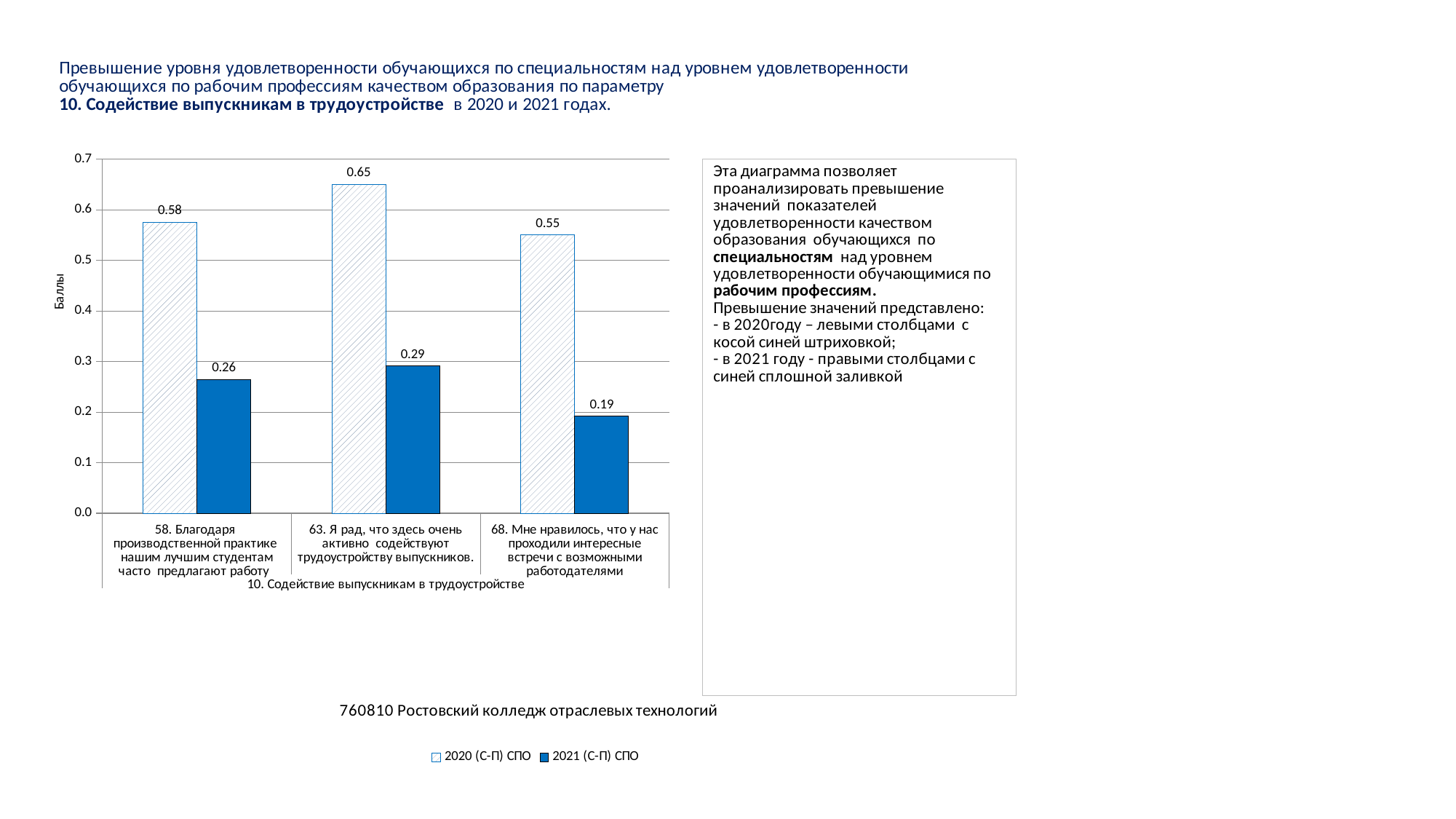
Is the 2020 (С-П) СПО value for item 63 greater or less than 0.6? greater What is the 2020 (С-П) СПО value for item 58 (Благодаря производственной практике нашим лучшим студентам часто предлагают работу)? 0.58 What is the 2021 (С-П) СПО value for item 63 (Я рад, что здесь очень активно содействуют трудоустройству выпускников)? 0.29 Which is larger for item 68: the 2020 (С-П) СПО value or the 2021 (С-П) СПО value? 2020 (С-П) СПО Which item has the highest 2020 (С-П) СПО value? 63. Я рад, что здесь очень активно содействуют трудоустройству выпускников. Which item has the lowest 2021 (С-П) СПО value? 68. Мне нравилось, что у нас проходили интересные встречи с возможными работодателями What kind of chart is shown on the slide? Bar chart What is the label of the vertical axis? Баллы How many categories (items) are shown on the x axis? 3 How many series does the legend list? 2 What is the 2021 (С-П) СПО value for item 68 (Мне нравилось, что у нас проходили интересные встречи с возможными работодателями)? 0.19 What is the difference between the 2020 and 2021 values for item 58? 0.32